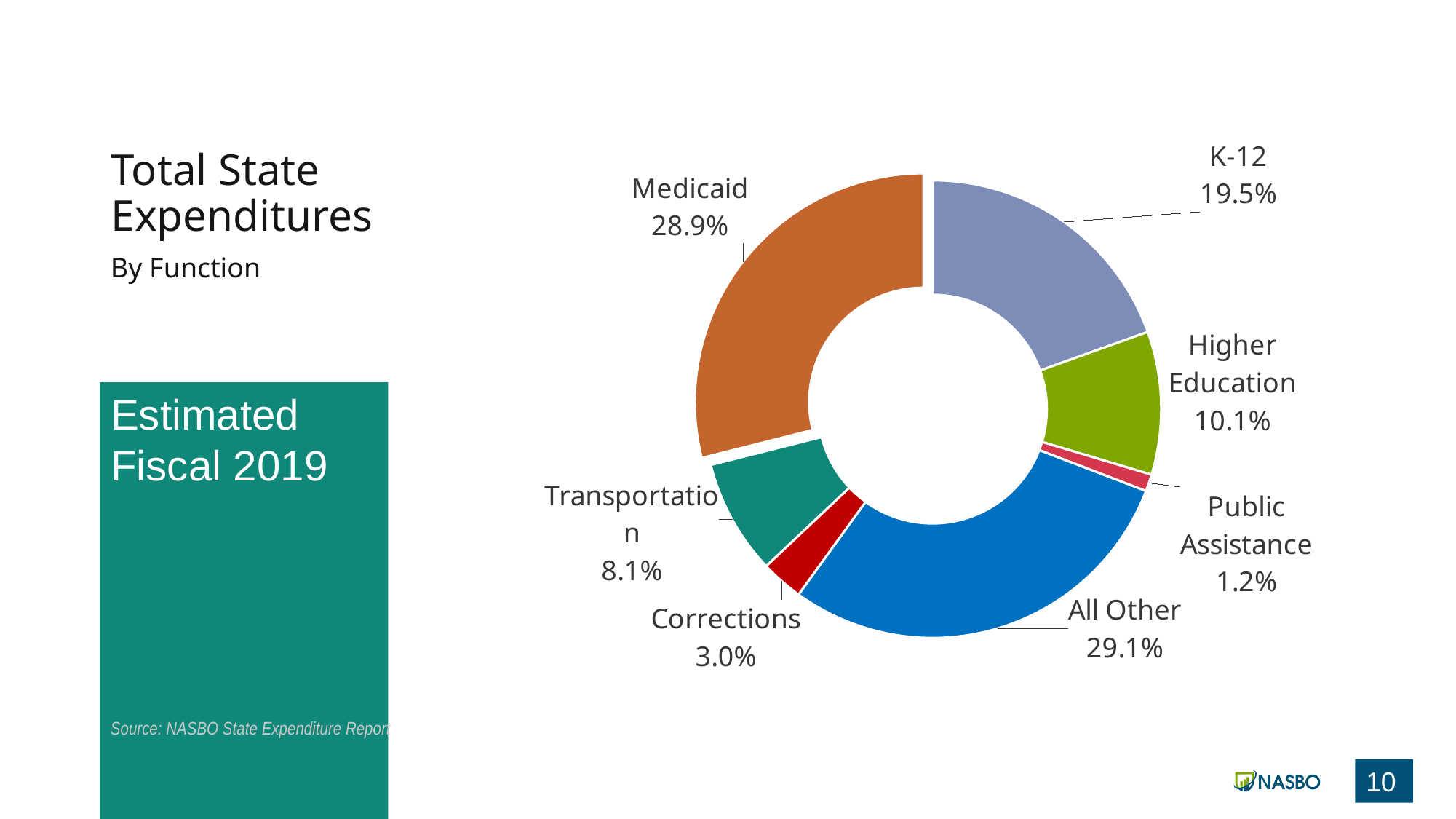
Which function has the smallest share of total state expenditures? Public Assistance Which function has the largest share of total state expenditures? All Other What fiscal year does the chart cover? Estimated Fiscal 2019 What share of expenditures is Corrections? 3.0% How many functions (slices) are shown in the chart? 7 What kind of chart is shown on the slide? doughnut (pie) chart What percentage of total state expenditures is K-12? 19.5% What is the difference in percentage points between Medicaid and K-12? 9.4 What share of total state expenditures goes to Medicaid? 28.9% What is the value shown for Higher Education? 10.1% Which is larger, the share for Higher Education or the share for Transportation? Higher Education What percentage is shown for Transportation? 8.1%